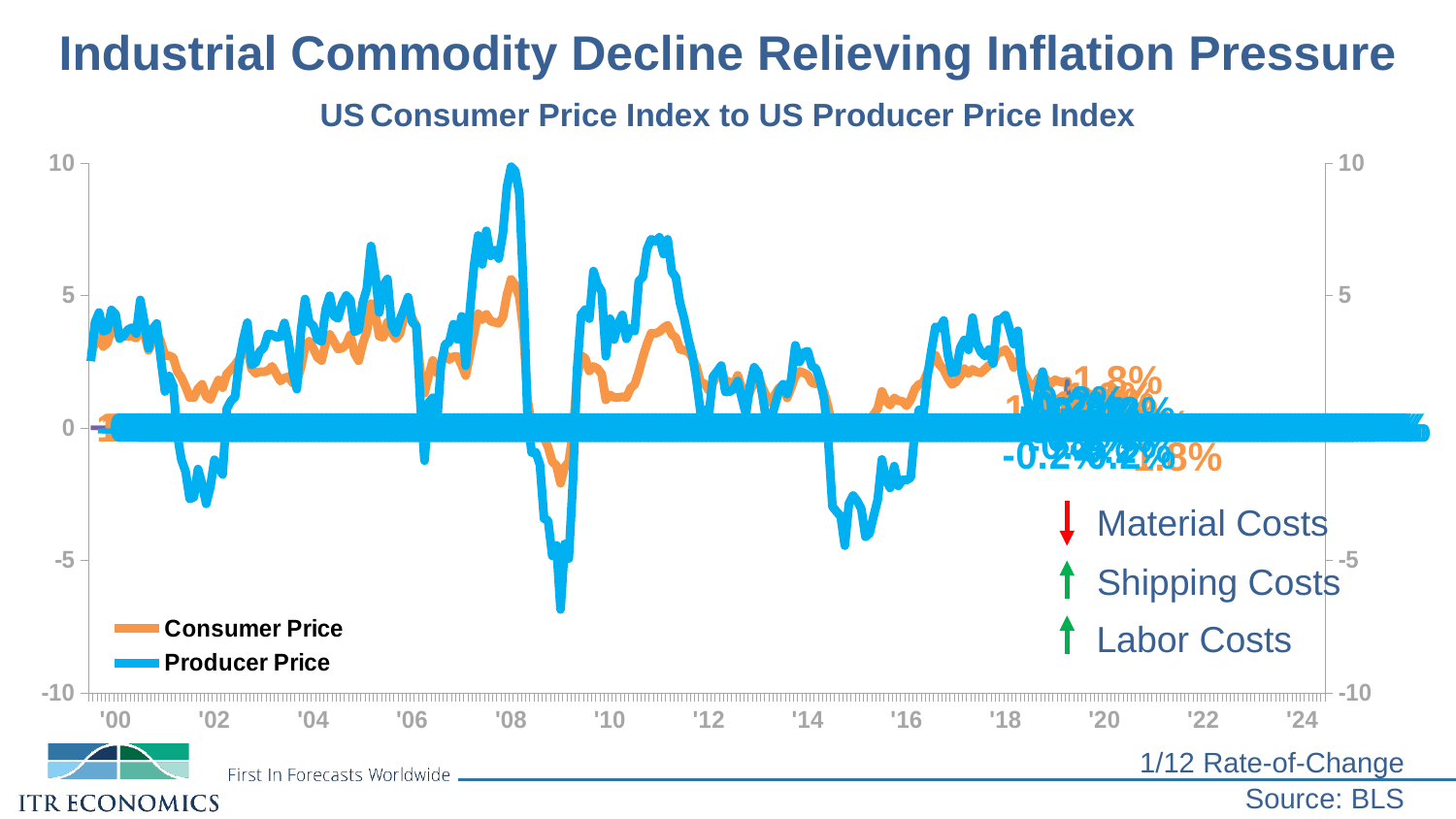
What colour is the Producer Price line in the chart? blue Is the Consumer Price line around 2009 greater or less than 0? less Is the Producer Price line around 2015 greater or less than 0? less Is the Consumer Price line around 2004 greater or less than 0? greater Which series reaches the lowest value anywhere on the chart, Consumer Price or Producer Price? Producer Price What kind of chart is shown on the slide? line chart What is the title of the chart? US Consumer Price Index to US Producer Price Index Which series reaches the highest value anywhere on the chart, Consumer Price or Producer Price? Producer Price Around 2008, which line is higher, Consumer Price or Producer Price? Producer Price How many series does the chart legend list? 2